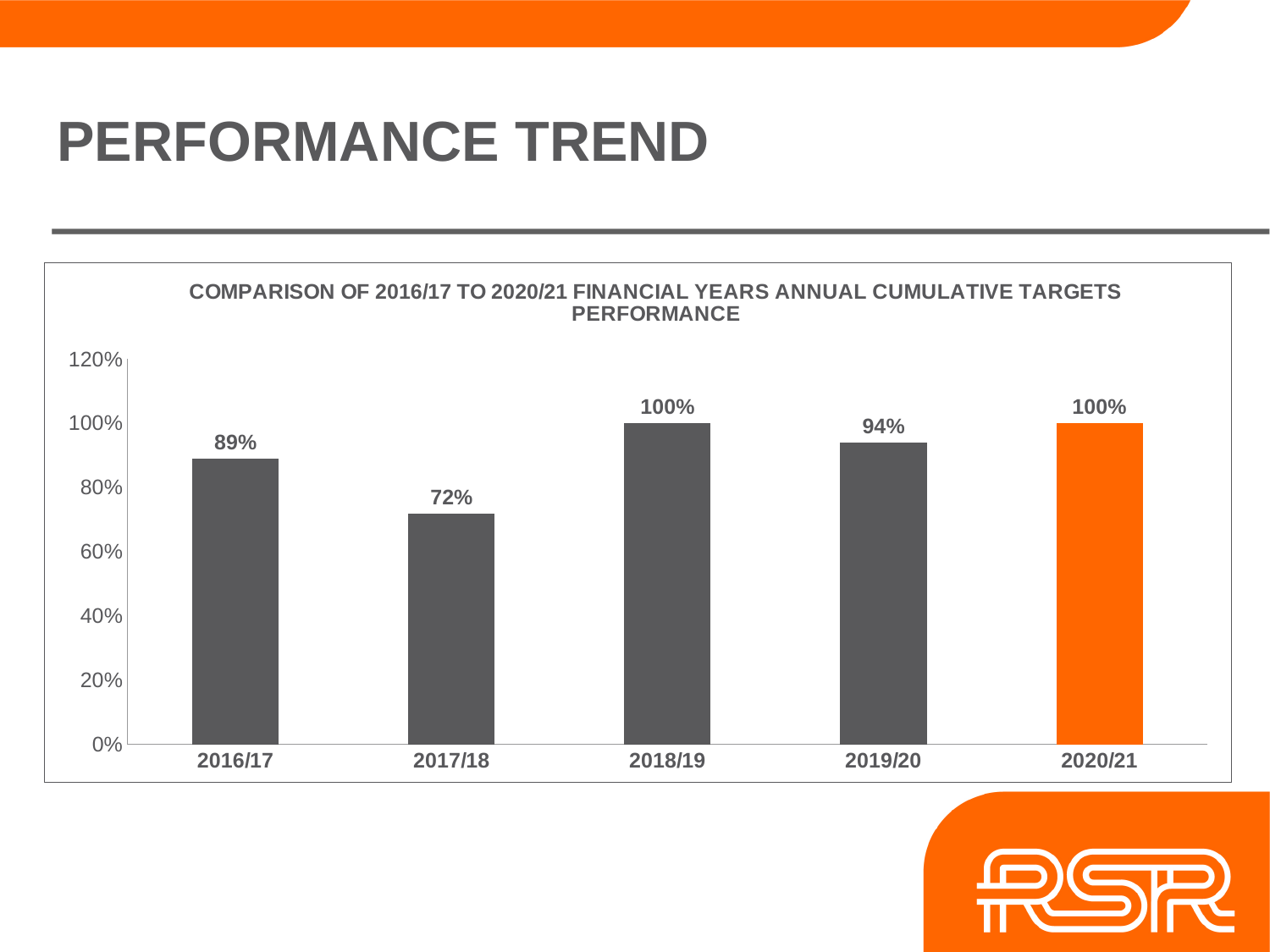
What is the difference between the values for 2018/19 and 2017/18? 28% Is the value for 2017/18 greater or less than 80%? less What is the value for 2016/17? 89% What is the value for 2017/18? 72% What kind of chart is shown on the slide? bar chart What is the value for 2019/20? 94% Which is larger, the value for 2016/17 or the value for 2019/20? 2019/20 Does the value rise or fall from 2017/18 to 2018/19? rise Which financial year has the lowest value? 2017/18 Which bar is coloured orange rather than grey? 2020/21 How many financial years are shown on the x axis? 5 What is the difference between the values for 2019/20 and 2016/17? 5%